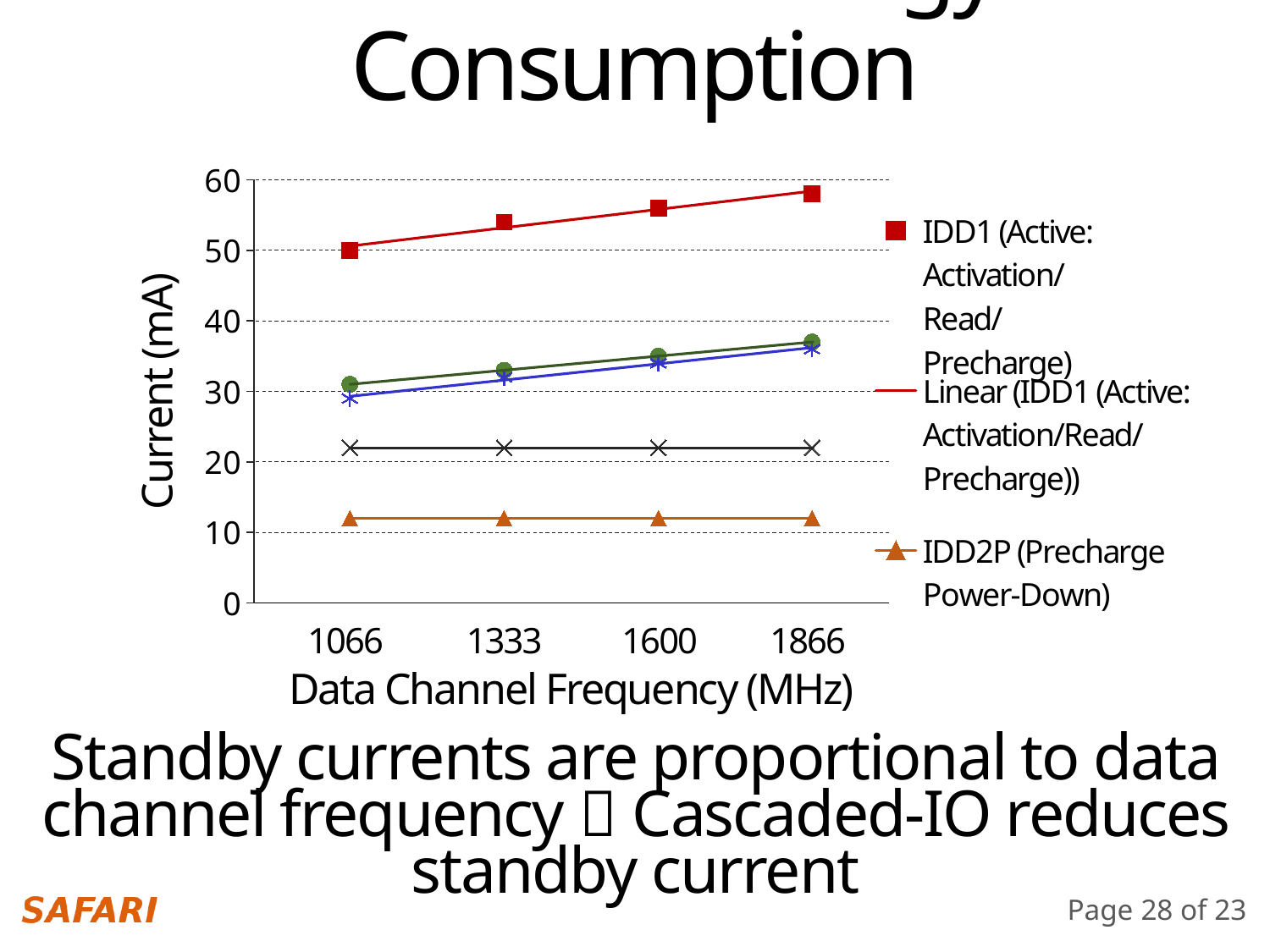
At which data channel frequency is the IDD1 (Active: Activation/Read/Precharge) current highest? 1866 What is the label of the y axis? Current (mA) What kind of chart is shown on the slide? line chart Is the IDD2P (Precharge Power-Down) value at 1066 MHz greater or less than 20? less At 1600 MHz, which is larger: IDD1 (Active: Activation/Read/Precharge) or IDD2P (Precharge Power-Down)? IDD1 (Active: Activation/Read/Precharge) What is the IDD1 (Active: Activation/Read/Precharge) current at 1066 MHz? 50 Is the IDD1 (Active: Activation/Read/Precharge) value at 1866 MHz greater or less than 50? greater How many series does the legend list? 3 Does the IDD2P (Precharge Power-Down) current rise, fall, or stay flat as data channel frequency increases? stay flat How many data channel frequency values are plotted along the x axis? 4 At which data channel frequency is the IDD1 (Active: Activation/Read/Precharge) current lowest? 1066 Does the IDD1 (Active: Activation/Read/Precharge) current rise or fall as data channel frequency increases? rise